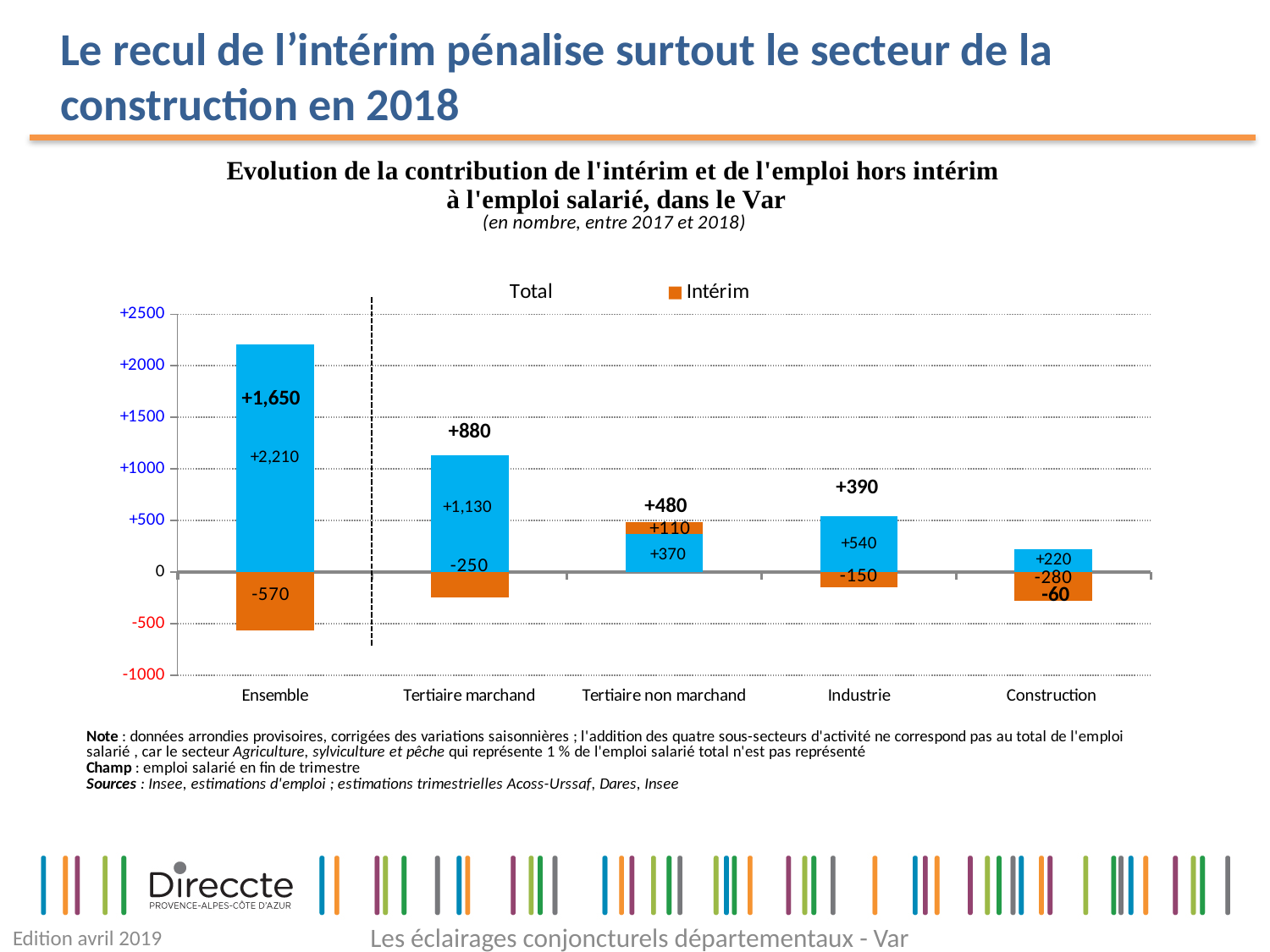
What colour represents Intérim in the legend? Orange Which has the larger Intérim value, Tertiaire non marchand or Industrie? Tertiaire non marchand What is the difference between the Intérim values for Ensemble (-570) and Construction (-280)? 290 How many categories are shown on the x axis? 5 What is the Intérim value for Ensemble? -570 Which category has the lowest total? Construction What is the value of the blue (hors intérim) segment for Tertiaire marchand? +1,130 Do the totals rise or fall from Ensemble to Construction along the x axis? Fall What is the Intérim value for Construction? -280 Which category has the highest total? Ensemble What is the total shown for Industrie? +390 What kind of chart is this? Bar chart